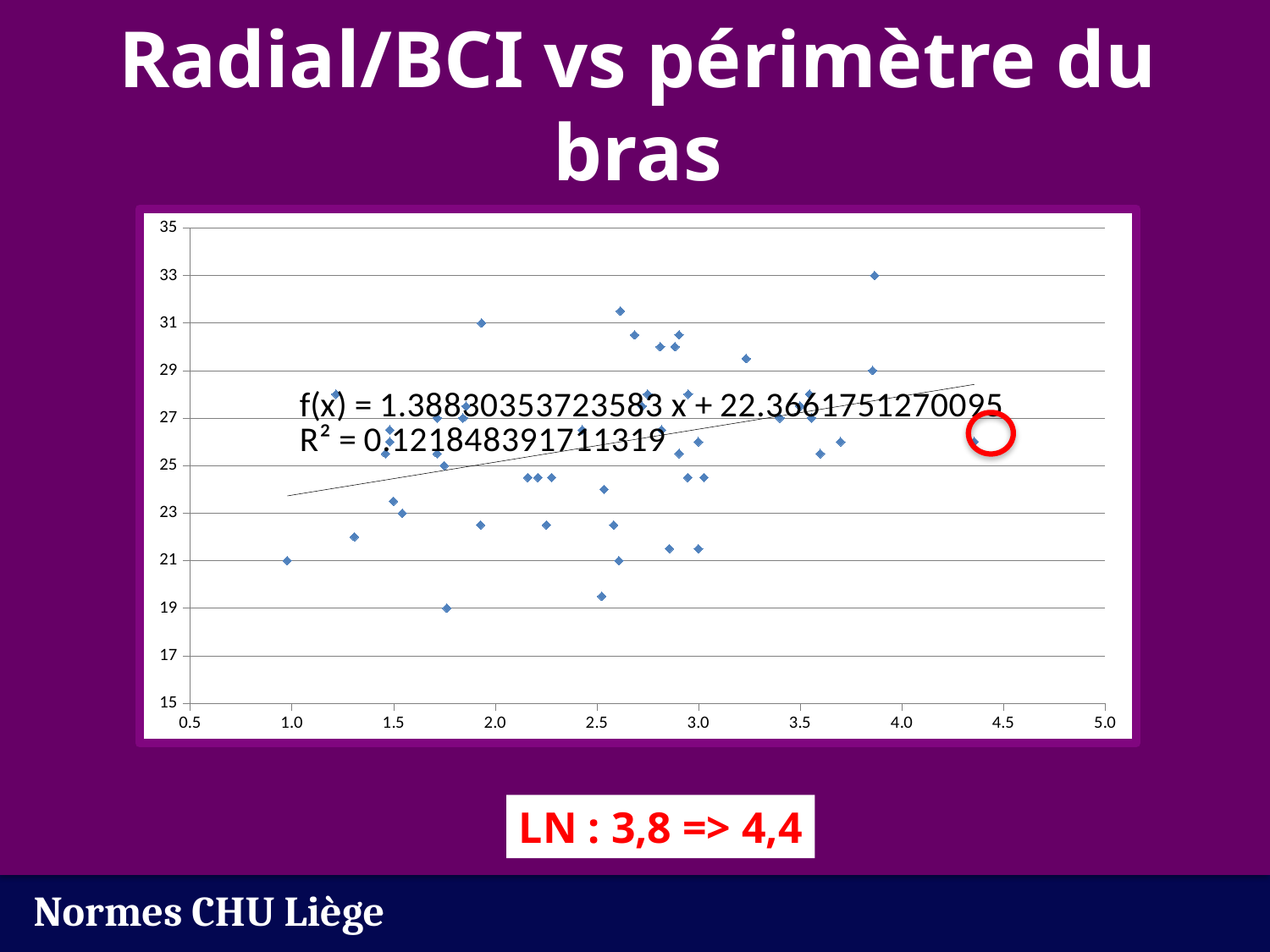
Is the y value of the point circled in red greater or less than 25? greater What is the R² value printed on the chart? 0.121848391711319 Is the x value of the point circled in red greater or less than 4.0? greater Is the y value of the highest plotted point greater or less than 31? greater Does the fitted trendline rise or fall as the x value increases? rises What kind of chart is shown on the slide? scatter plot What is the slope coefficient in the fitted equation f(x) printed on the chart? 1.38830353723583